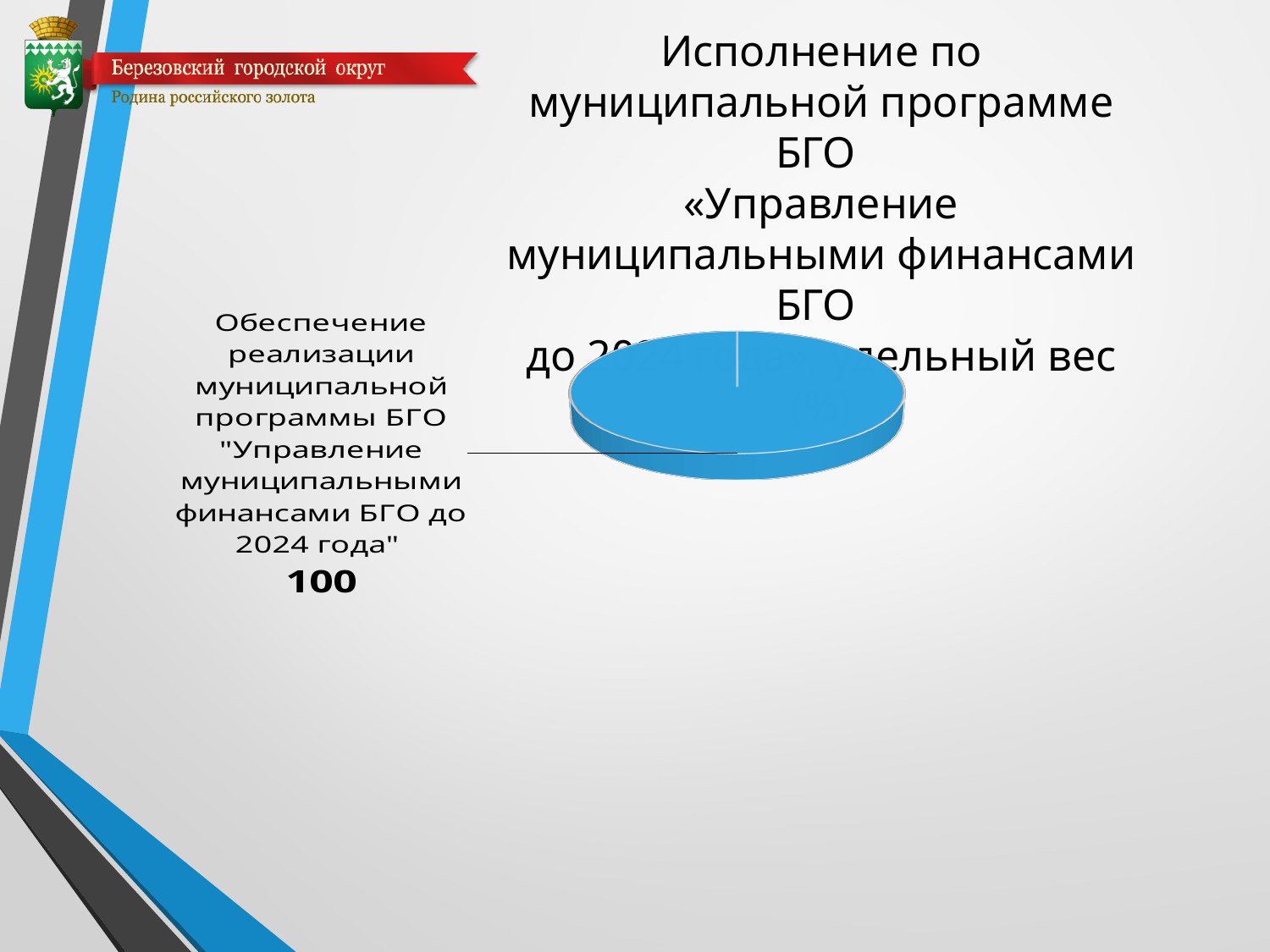
What share of the pie does the slice "Обеспечение реализации муниципальной программы БГО "Управление муниципальными финансами БГО до 2024 года"" take up? 100% Is the pie chart drawn in 3D or flat? 3D What value is shown for the slice "Обеспечение реализации муниципальной программы БГО "Управление муниципальными финансами БГО до 2024 года""? 100 Is the value for the slice "Обеспечение реализации муниципальной программы БГО "Управление муниципальными финансами БГО до 2024 года"" greater or less than 50? greater What colour is the single slice of the pie chart? blue How many slices does the pie chart have? 1 What kind of chart is shown on the slide? pie chart